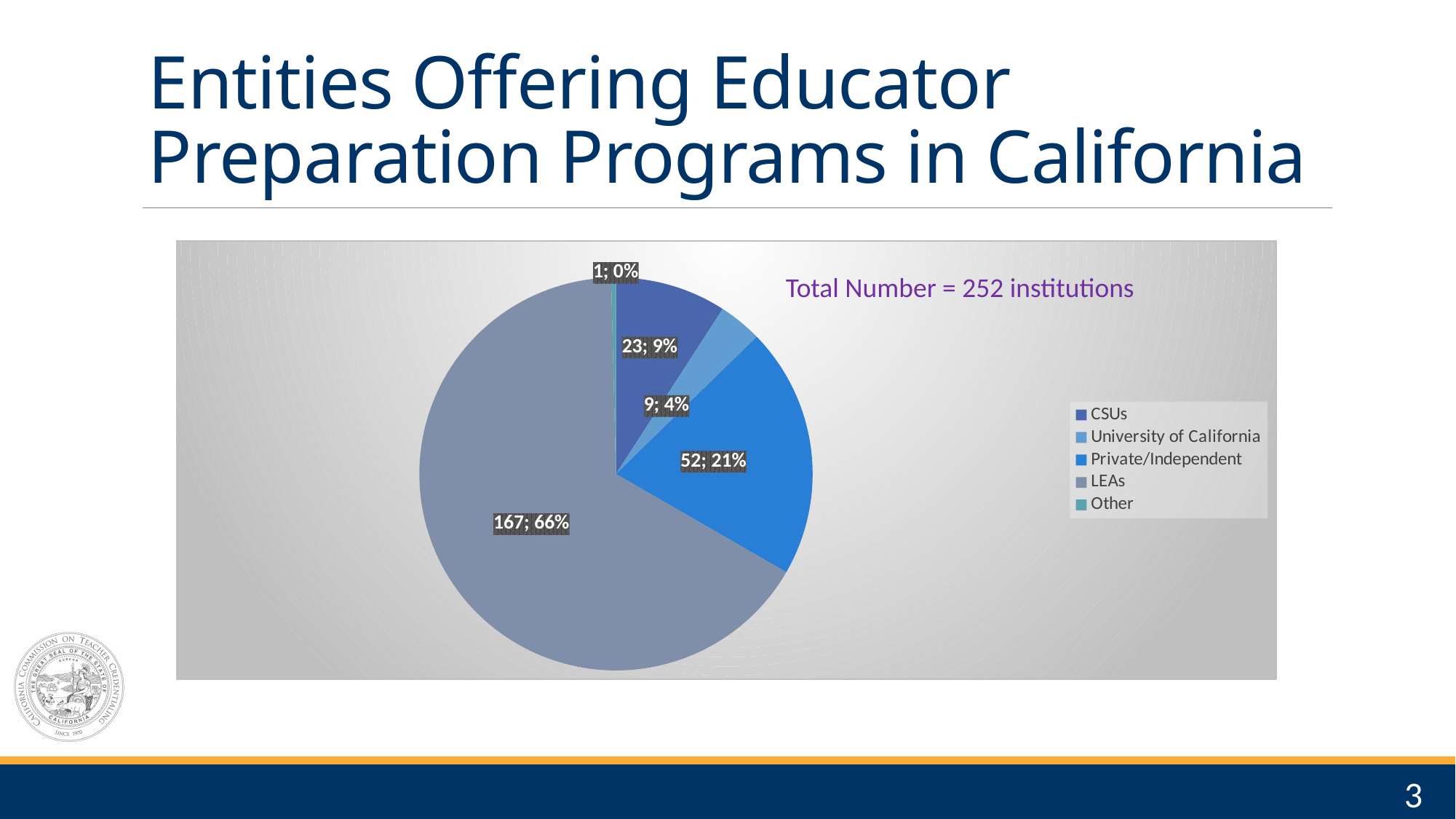
Which is larger, the number of CSUs or the number of University of California institutions? CSUs How many categories does the legend list? 5 How many institutions are CSUs according to the pie chart? 23 What share of the pie do LEAs represent? 66% What share of the pie does University of California represent? 4% What kind of chart is shown on the slide? pie chart What is the difference between the number of LEAs and the number of Private/Independent institutions? 115 How many institutions are LEAs according to the pie chart? 167 What total number of institutions is stated on the chart? 252 institutions Which category has the largest slice of the pie? LEAs Which category has the smallest slice of the pie? Other How many institutions are Private/Independent according to the pie chart? 52